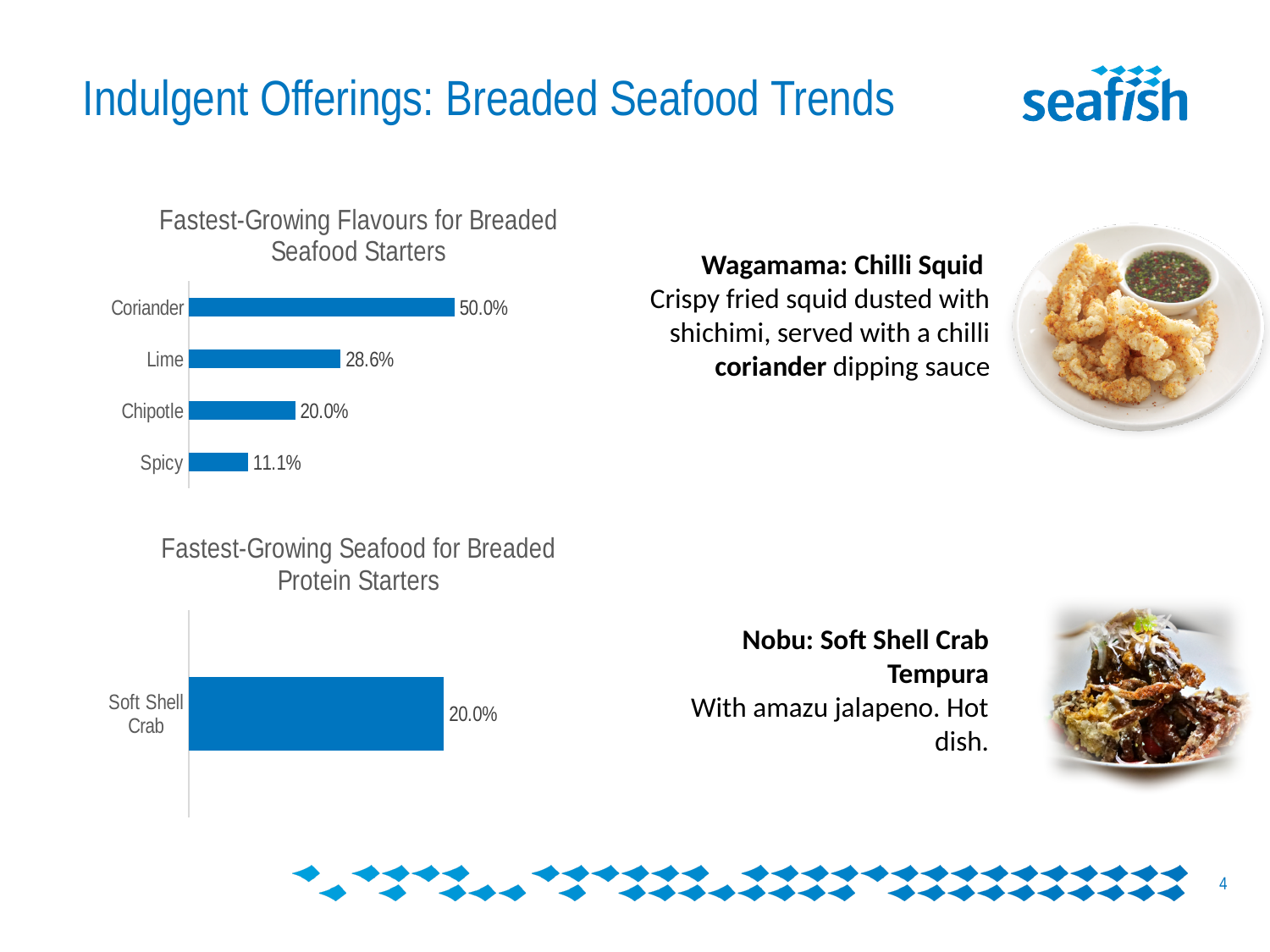
In the 'Fastest-Growing Flavours for Breaded Seafood Starters' chart, what is the value for Coriander? 50.0% What kind of chart is the 'Fastest-Growing Flavours for Breaded Seafood Starters' chart? Bar chart How many flavours are shown in the 'Fastest-Growing Flavours for Breaded Seafood Starters' chart? 4 In the 'Fastest-Growing Flavours for Breaded Seafood Starters' chart, what is the value for Lime? 28.6% In the 'Fastest-Growing Flavours for Breaded Seafood Starters' chart, what is the value for Chipotle? 20.0% In the 'Fastest-Growing Flavours for Breaded Seafood Starters' chart, which flavour has the highest value? Coriander How many categories are shown in the 'Fastest-Growing Seafood for Breaded Protein Starters' chart? 1 In the 'Fastest-Growing Seafood for Breaded Protein Starters' chart, what is the value for Soft Shell Crab? 20.0% In the 'Fastest-Growing Flavours for Breaded Seafood Starters' chart, what is the difference between the values for Coriander and Lime? 21.4% In the 'Fastest-Growing Flavours for Breaded Seafood Starters' chart, what is the value for Spicy? 11.1% In the 'Fastest-Growing Flavours for Breaded Seafood Starters' chart, which flavour has the lowest value? Spicy In the 'Fastest-Growing Flavours for Breaded Seafood Starters' chart, which is larger, the value for Chipotle or the value for Spicy? Chipotle